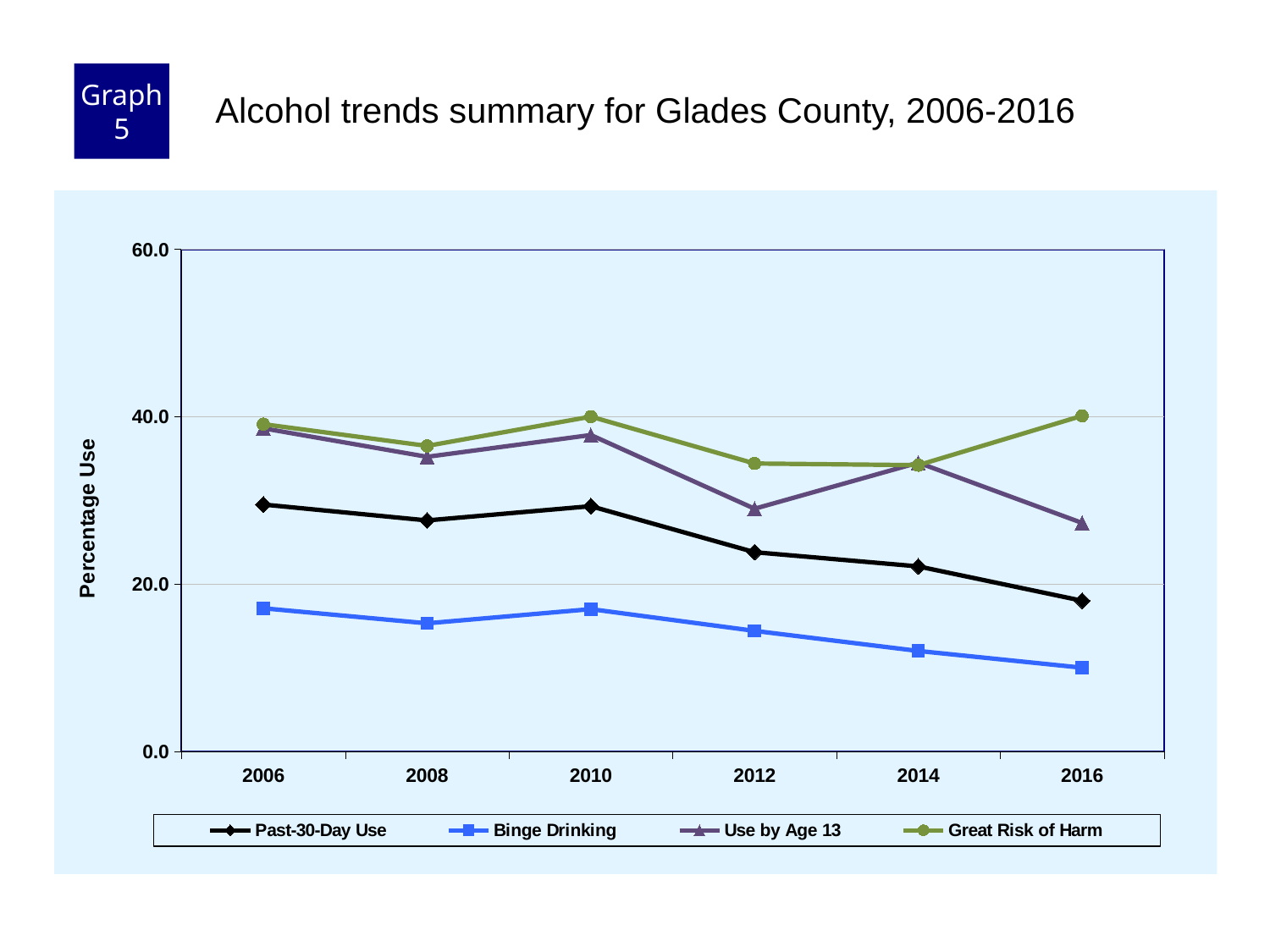
In 2016, which series has the higher value: Great Risk of Harm or Use by Age 13? Great Risk of Harm Is the value for Past-30-Day Use in 2006 greater or less than 20.0? greater What kind of chart is shown on the slide? line chart Is the value for Use by Age 13 in 2012 greater or less than 40.0? less How many series does the legend list? 4 What is the label on the y axis? Percentage Use Is the value for Great Risk of Harm in 2012 greater or less than 40.0? less Does Binge Drinking rise or fall from 2010 to 2016? fall How many years are plotted along the x axis? 6 In which year is Binge Drinking at its lowest? 2016 Which series has the highest value in 2016? Great Risk of Harm